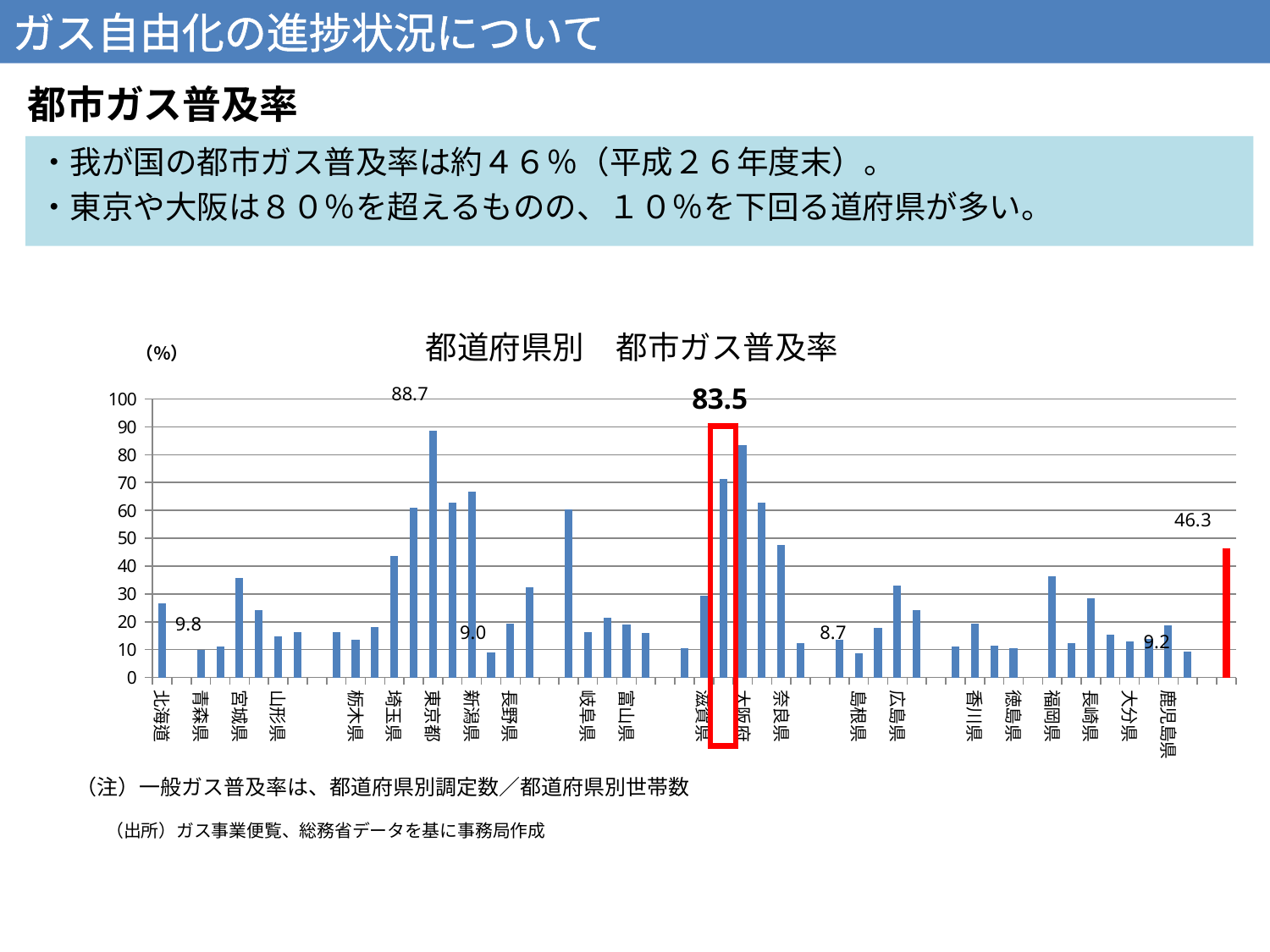
What is the difference between the values for 東京都 and 大阪府? 5.2 What is the value for 東京都 in the 都道府県別 都市ガス普及率 chart? 88.7 What kind of chart is shown on the slide? bar chart What is the title of the chart? 都道府県別 都市ガス普及率 What value is labelled on the red bar at the far right of the chart? 46.3 Is the value for 北海道 greater or less than 20? greater Which is larger, the value for 東京都 or the value for 大阪府? 東京都 Which is larger, the value for 宮城県 or the value for 山形県? 宮城県 Which prefecture has the highest value in the chart? 東京都 What is the difference between the value for 東京都 and the red bar's value of 46.3? 42.4 Is the value for 奈良県 greater or less than 40? greater What is the value for 大阪府 in the chart? 83.5